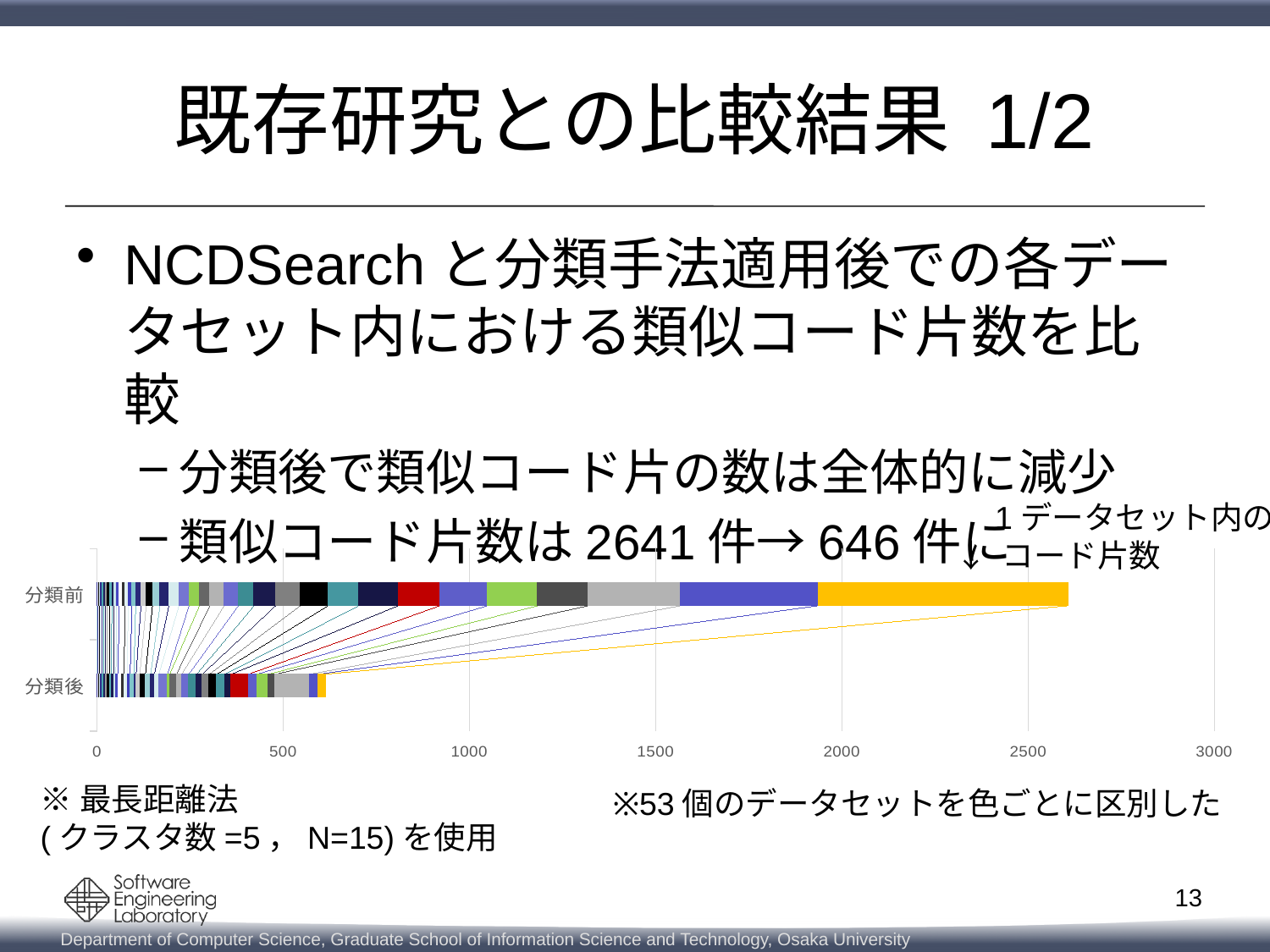
Which bar is longer, 分類前 or 分類後? 分類前 According to the note on the slide, how many datasets are distinguished by colour in the chart? 53 Is the total for 分類後 greater or less than 1000? less How many categories (bars) does the chart show? 2 According to the slide, what is the total number of similar code fragments for 分類後? 646 件 Is the total for 分類後 greater or less than 500? greater What kind of chart is shown on the slide? Stacked bar chart Is the total for 分類前 greater or less than 2000? greater Which category has the highest total? 分類前 What is the highest value shown on the x axis? 3000 According to the slide, what is the total number of similar code fragments for 分類前? 2641 件 Which category has the lowest total? 分類後